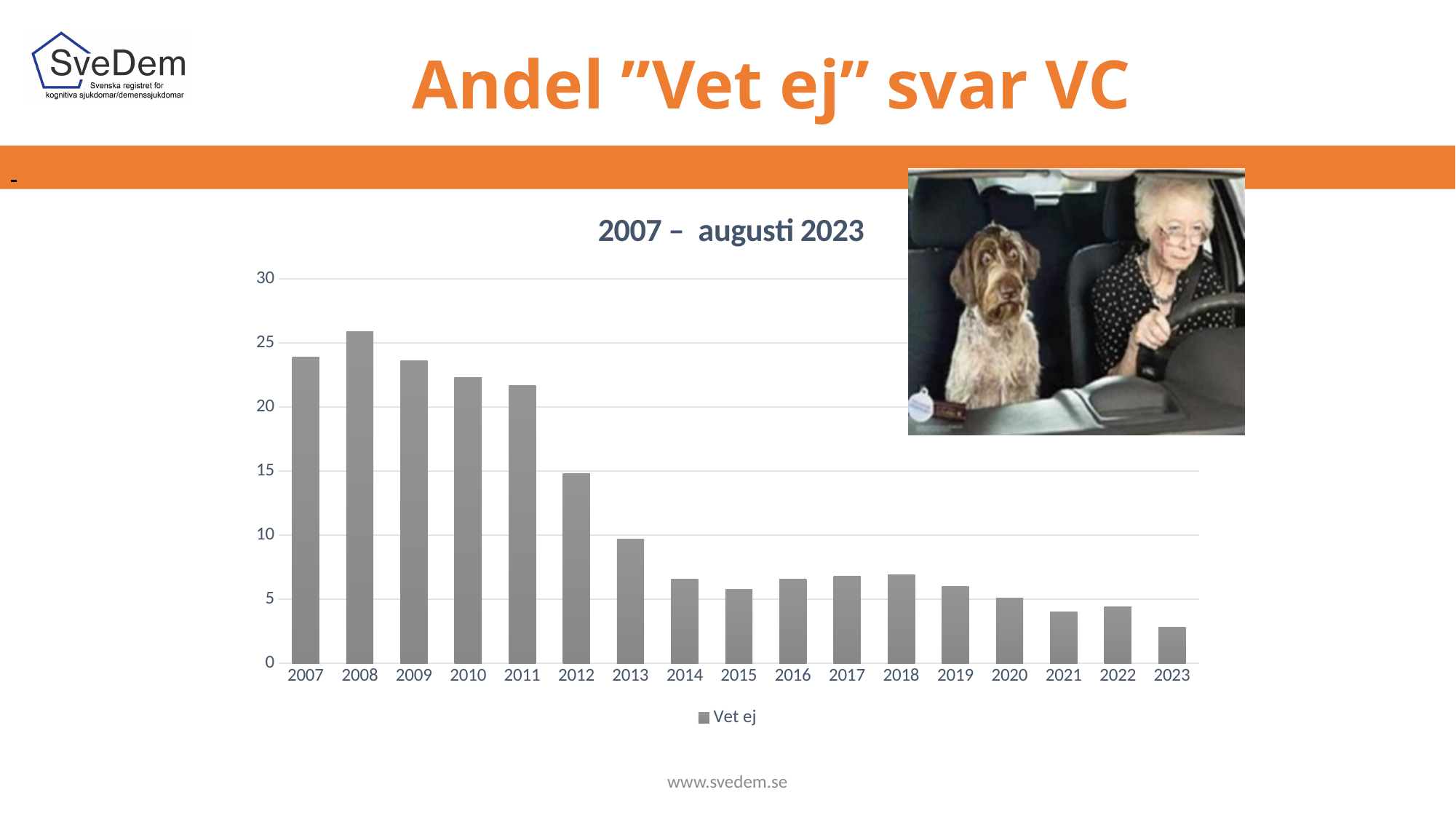
What kind of chart is shown on the slide? bar chart Is the value for 2008 greater or less than 25? greater How many years are shown on the x axis? 17 Which year has the highest "Vet ej" share? 2008 Is the value for 2023 greater or less than 5? less Is the value for 2011 greater or less than 20? greater Do the values generally rise or fall from 2007 to 2023? fall How many series does the legend list? 1 Which is larger, the value for 2007 or the value for 2012? 2007 Which year has the lowest "Vet ej" share? 2023 What is the legend entry for the series shown? Vet ej